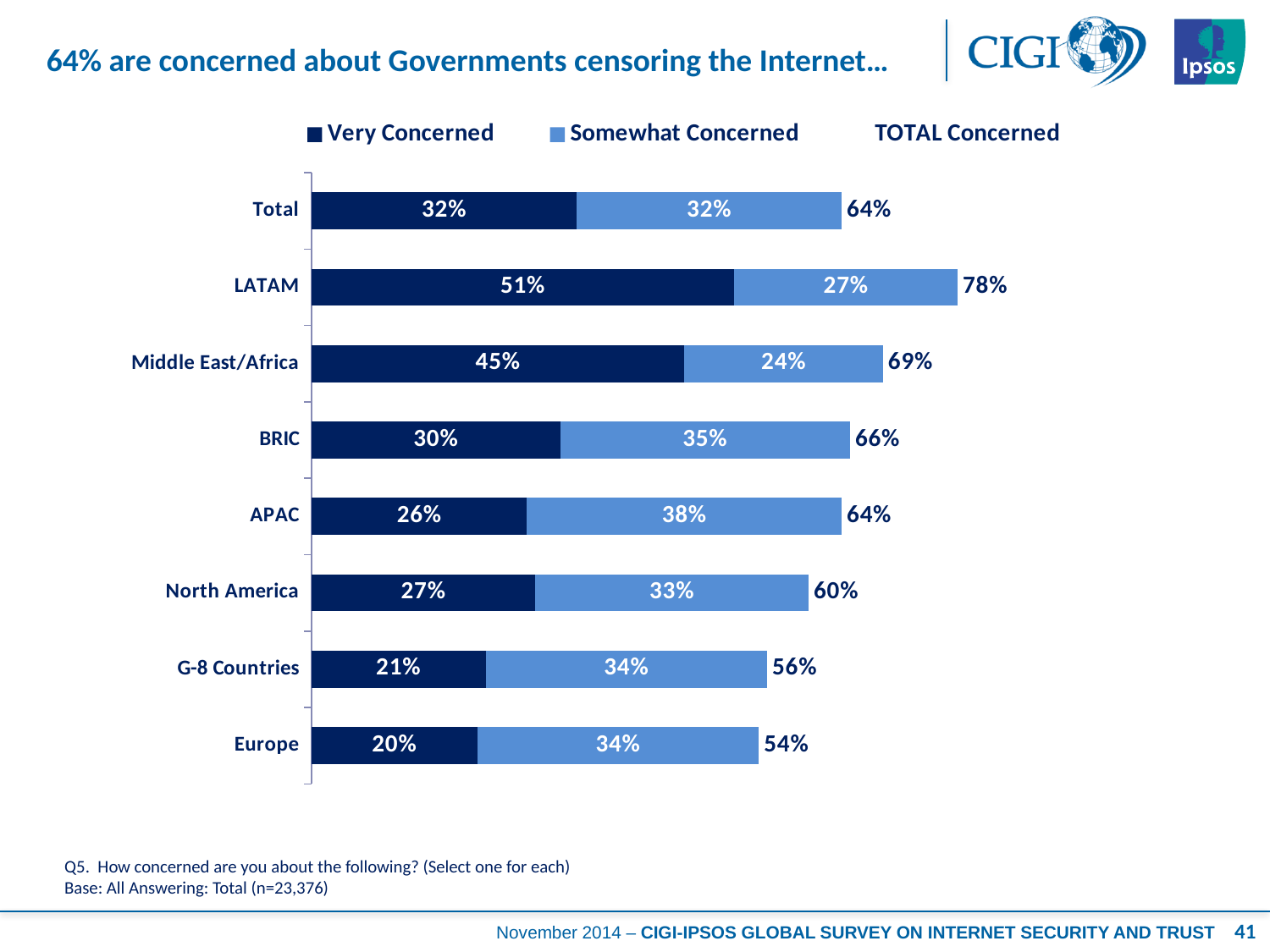
What percentage of LATAM respondents are Very Concerned? 51% What kind of chart is shown on the slide? Stacked bar chart How many categories are shown on the chart? 8 What is the Somewhat Concerned value for APAC? 38% What is the TOTAL Concerned value for North America? 60% Which has a larger Very Concerned value, Middle East/Africa or BRIC? Middle East/Africa What is the total of the stacked bar for G-8 Countries? 56% Which series is shown in dark blue? Very Concerned Which region has the highest TOTAL Concerned value? LATAM How many series does the legend list with coloured markers? 2 What is the difference between the TOTAL Concerned values for LATAM and Europe? 24% Which region has the lowest Very Concerned value? Europe